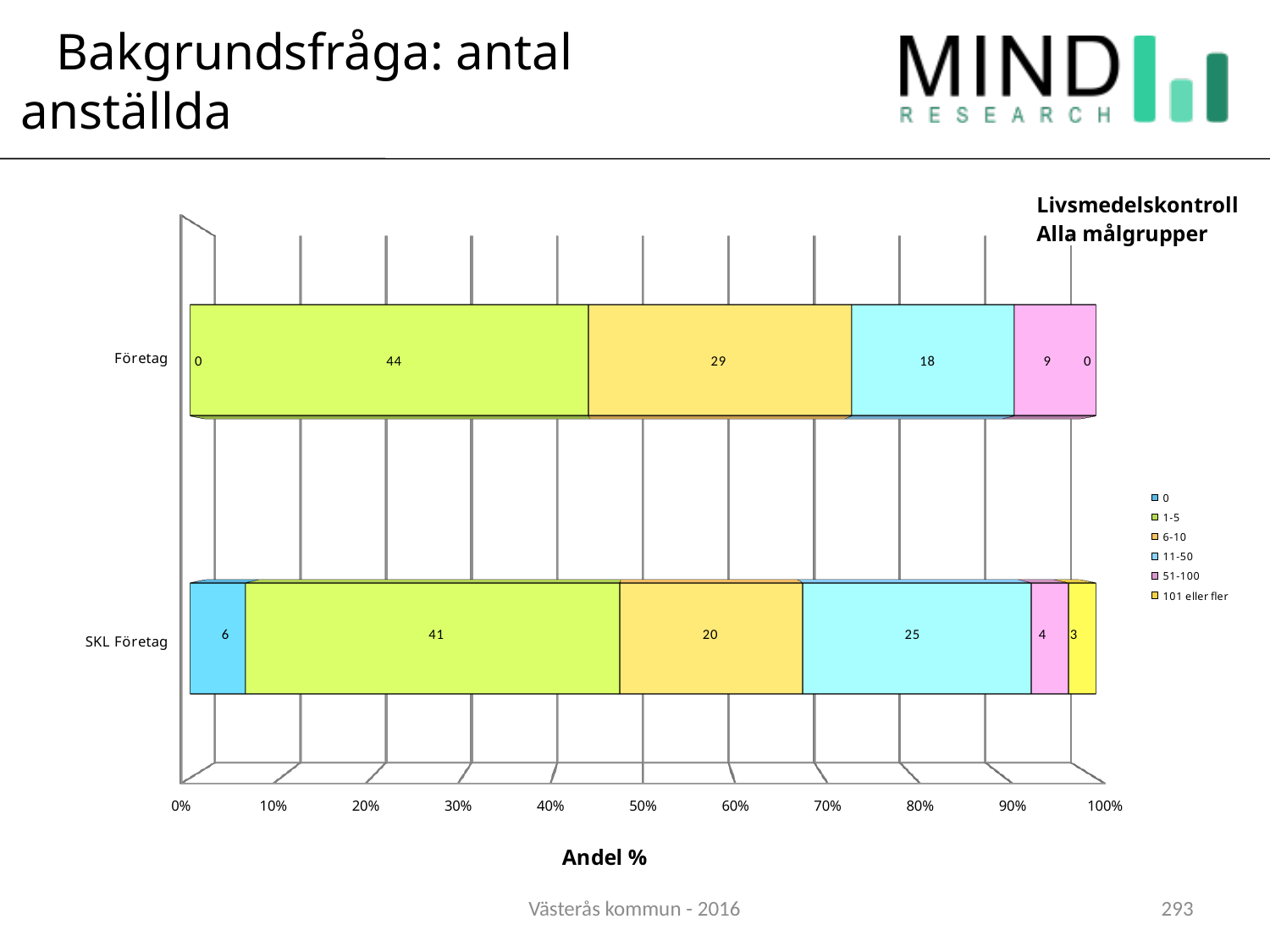
What kind of chart is shown on the slide? Stacked bar chart Which is larger: the 11-50 value for Företag or for SKL Företag? SKL Företag Which series has the highest value in the SKL Företag bar? 1-5 How many series does the legend list? 6 What is the value for the 6-10 series in the Företag bar? 29 What is the label of the x axis? Andel % What is the difference between the 6-10 values for Företag and SKL Företag? 9 What is the value for the 1-5 series in the Företag bar? 44 What is the value for the 0 series in the SKL Företag bar? 6 What is the value for the 11-50 series in the SKL Företag bar? 25 What is the total of the SKL Företag stacked bar? 99 How many categories (bars) are shown on the chart? 2